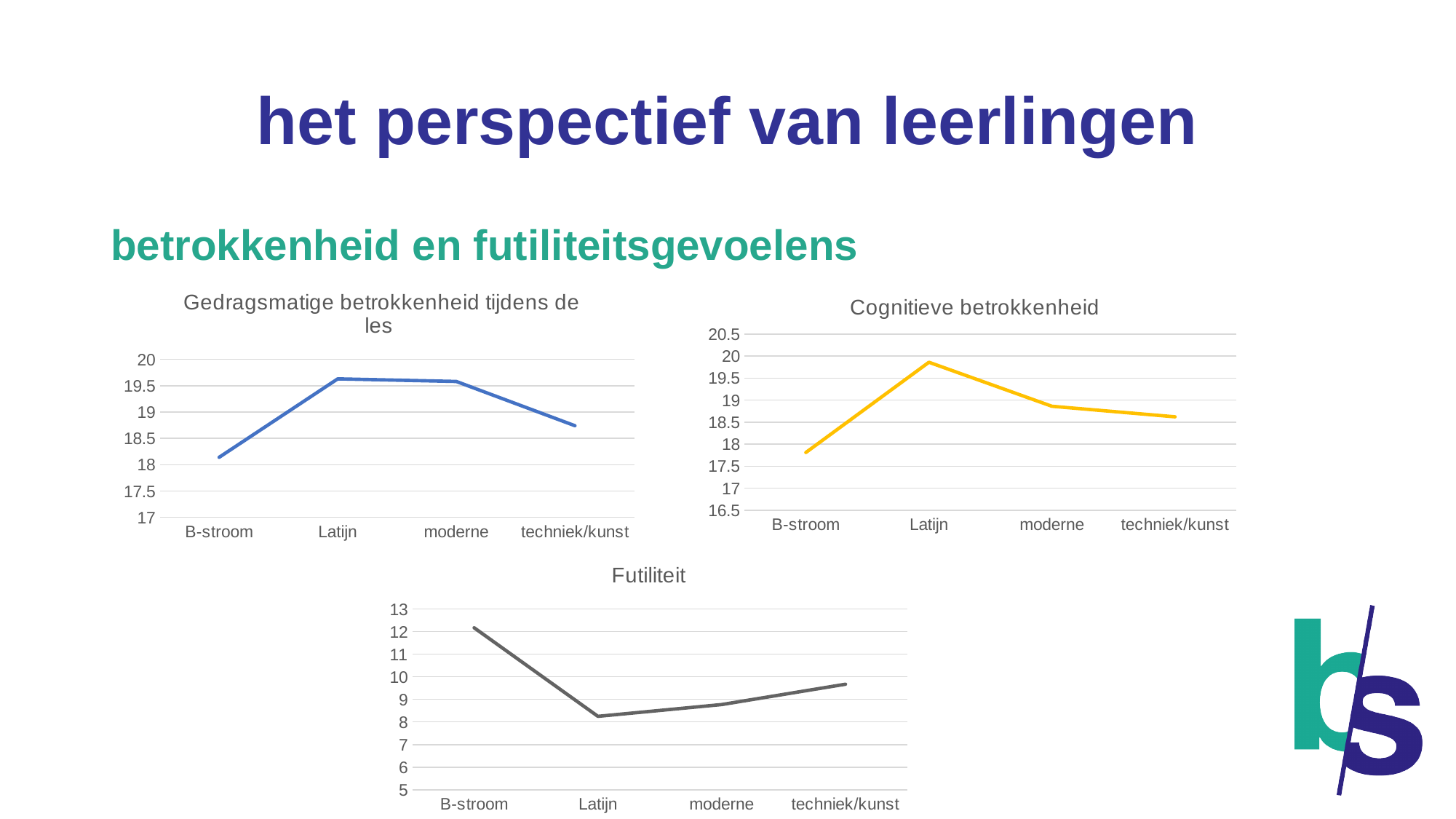
In the 'Futiliteit' chart, which is larger, the value for moderne or the value for techniek/kunst? techniek/kunst In the 'Gedragsmatige betrokkenheid tijdens de les' chart, is the value for B-stroom greater or less than 18.5? less What kind of chart is the 'Futiliteit' chart? line chart In the 'Futiliteit' chart, is the value for techniek/kunst greater or less than 10? less In the 'Cognitieve betrokkenheid' chart, is the value for Latijn greater or less than 20? less In the 'Futiliteit' chart, which category has the lowest value? Latijn In the 'Futiliteit' chart, which category has the highest value? B-stroom In the 'Cognitieve betrokkenheid' chart, do the values rise or fall from Latijn to techniek/kunst? fall In the 'Cognitieve betrokkenheid' chart, which category has the highest value? Latijn In the 'Gedragsmatige betrokkenheid tijdens de les' chart, which category has the lowest value? B-stroom How many categories are shown on the x axis of the 'Cognitieve betrokkenheid' chart? 4 In the 'Cognitieve betrokkenheid' chart, which category has the lowest value? B-stroom